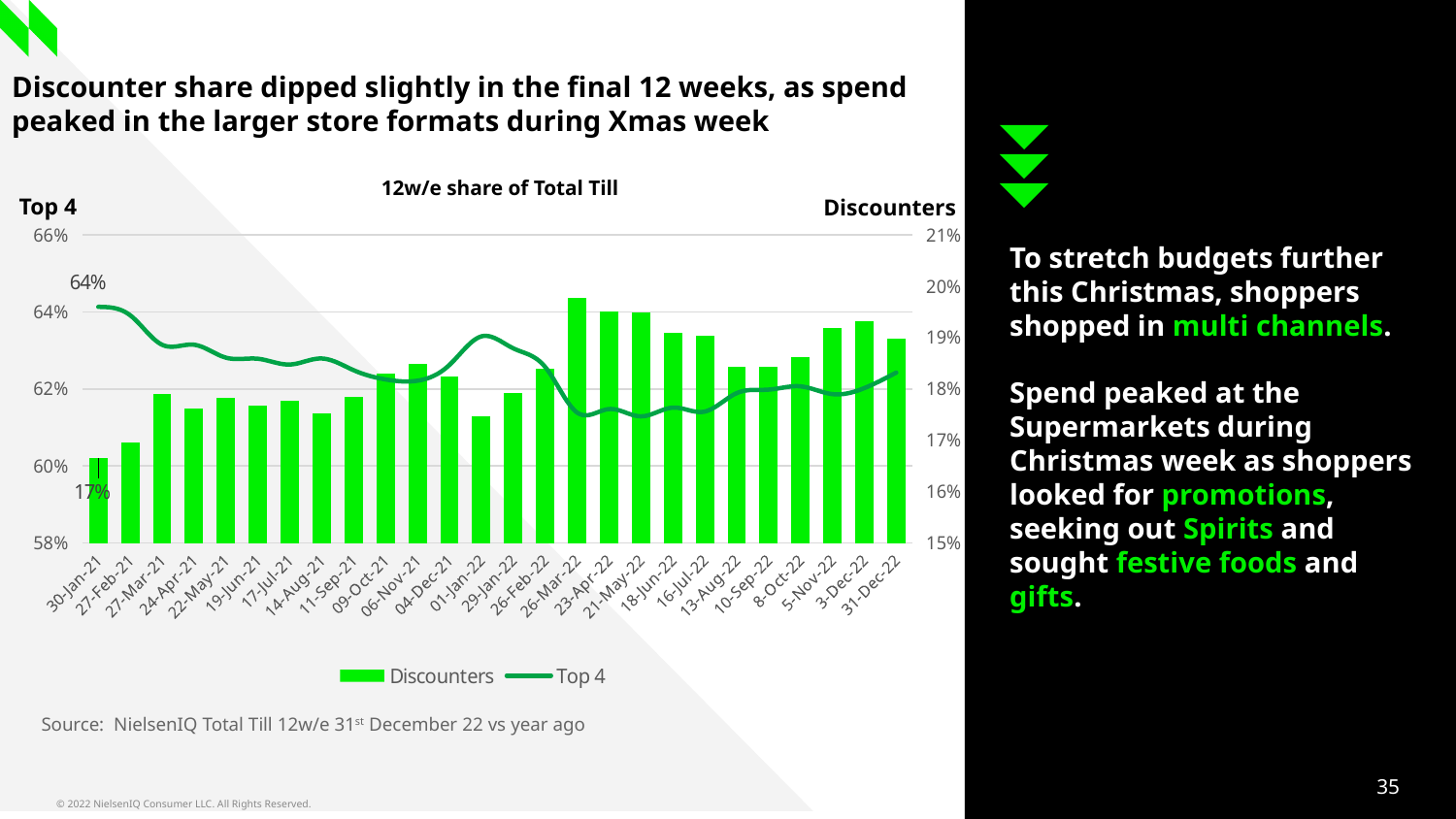
Does the Top 4 share rise or fall from 30-Jan-21 to 11-Sep-21? fall What kind of chart is shown on the slide? A combined bar and line chart What is the Discounters share at 30-Jan-21? 17% Which is larger, the Discounters share at 26-Mar-22 or at 30-Jan-21? 26-Mar-22 What is the chart's title? 12w/e share of Total Till Which series is drawn as bars? Discounters Is the Discounters share at 26-Mar-22 greater or less than 19%? greater Which period has the lowest Discounters share? 30-Jan-21 What is the Top 4 share at 30-Jan-21? 64% Which period has the highest Top 4 share? 30-Jan-21 Which period has the highest Discounters share? 26-Mar-22 How many series does the legend list? 2